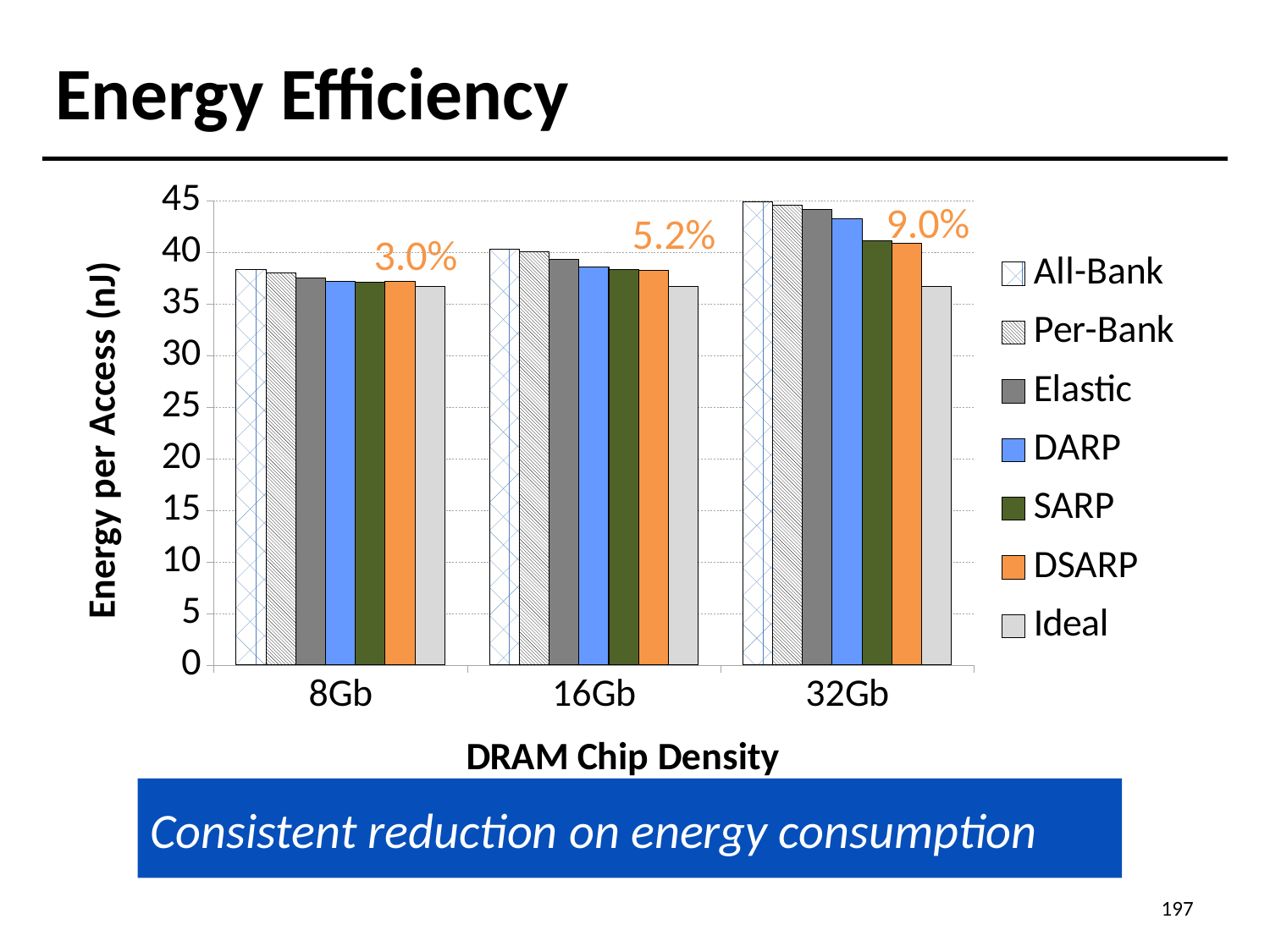
Is the DSARP value for 32Gb greater or less than 45? less How many DRAM chip density categories are shown on the x axis? 3 What kind of chart is shown on the slide? bar chart Which series has the lowest bar in the 32Gb group? Ideal Is the Ideal value for 16Gb greater or less than 40? less At 32Gb, which is larger, the All-Bank bar or the Ideal bar? All-Bank Is the All-Bank value for 32Gb greater or less than 40? greater Which is larger, the All-Bank value for 32Gb or the All-Bank value for 8Gb? 32Gb What percentage is annotated above the 32Gb group? 9.0% Does the All-Bank value rise or fall as DRAM chip density increases from 8Gb to 32Gb? rise How many series does the legend list? 7